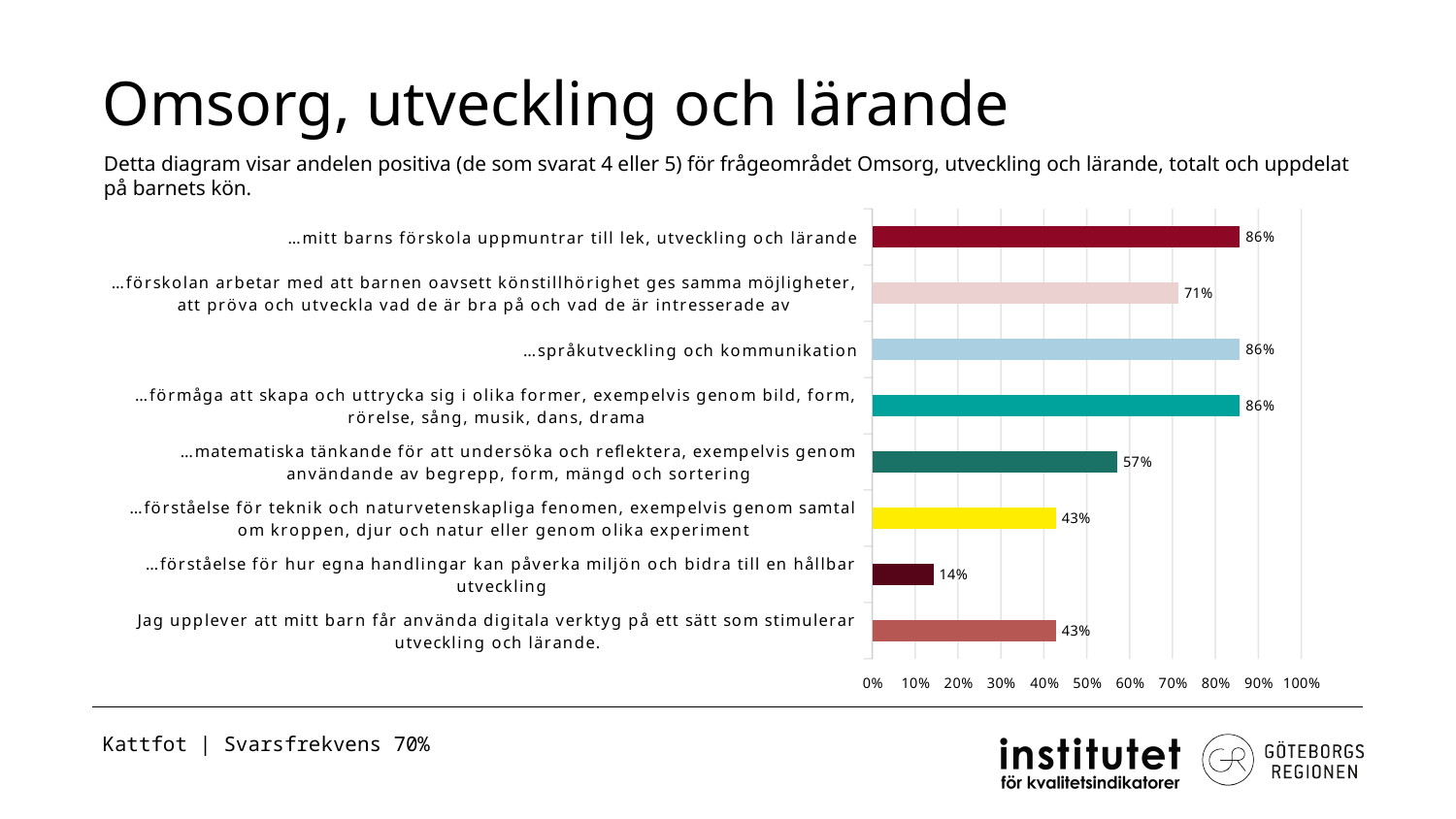
What is the title of the slide? Omsorg, utveckling och lärande What is the value for "…förskolan arbetar med att barnen oavsett könstillhörighet ges samma möjligheter, att pröva och utveckla vad de är bra på och vad de är intresserade av"? 71% What is the value for "…matematiska tänkande för att undersöka och reflektera, exempelvis genom användande av begrepp, form, mängd och sortering"? 57% What is the difference between the value for "…matematiska tänkande för att undersöka och reflektera, exempelvis genom användande av begrepp, form, mängd och sortering" and the value for "…förståelse för teknik och naturvetenskapliga fenomen, exempelvis genom samtal om kroppen, djur och natur eller genom olika experiment"? 14% What kind of chart is shown on the slide? bar chart What is the difference between the value for "…mitt barns förskola uppmuntrar till lek, utveckling och lärande" and the value for "…förståelse för hur egna handlingar kan påverka miljön och bidra till en hållbar utveckling"? 72% How many categories are shown in the chart? 8 Which is larger: the value for "…förskolan arbetar med att barnen oavsett könstillhörighet ges samma möjligheter, att pröva och utveckla vad de är bra på och vad de är intresserade av" or the value for "…matematiska tänkande för att undersöka och reflektera, exempelvis genom användande av begrepp, form, mängd och sortering"? …förskolan arbetar med att barnen oavsett könstillhörighet ges samma möjligheter, att pröva och utveckla vad de är bra på och vad de är intresserade av What is the value for "…språkutveckling och kommunikation"? 86% Is the value for "Jag upplever att mitt barn får använda digitala verktyg på ett sätt som stimulerar utveckling och lärande." greater or less than 50%? less Which category has the lowest value? …förståelse för hur egna handlingar kan påverka miljön och bidra till en hållbar utveckling What is the value for "…förståelse för hur egna handlingar kan påverka miljön och bidra till en hållbar utveckling"? 14%